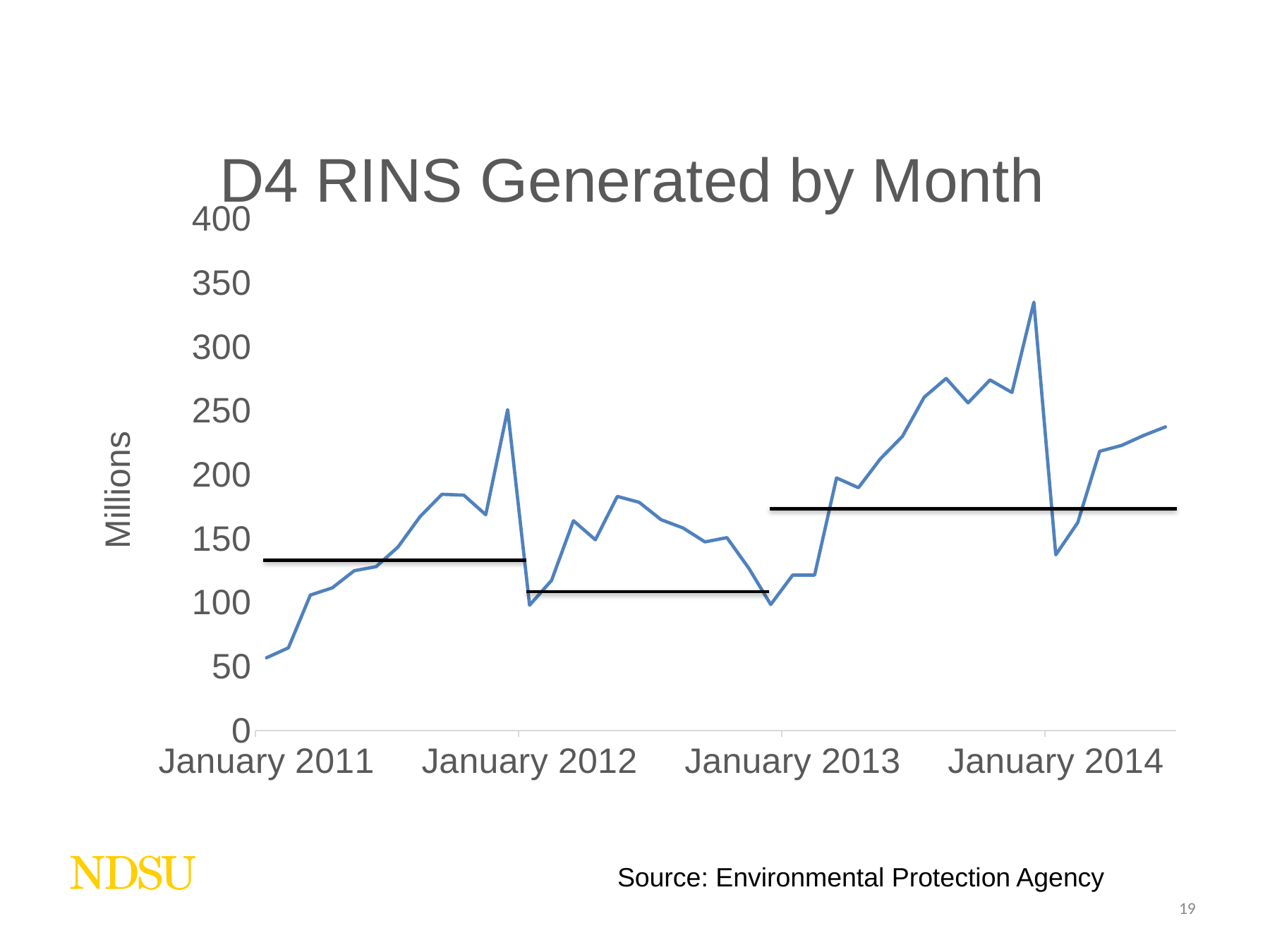
In which year does the line reach its highest value? 2013 What is the title of the chart? D4 RINS Generated by Month What is the maximum value shown on the vertical axis? 400 Is the highest point on the line greater or less than 300? greater Is the value for January 2011 greater or less than 100? less Is the value at the last plotted point (after January 2014) greater or less than 200? greater Overall, does the line rise or fall from January 2011 to the end of the series? Rise What is the label on the vertical axis of the chart? Millions What type of chart is shown on the slide? Line chart How many year labels are shown on the horizontal axis? 4